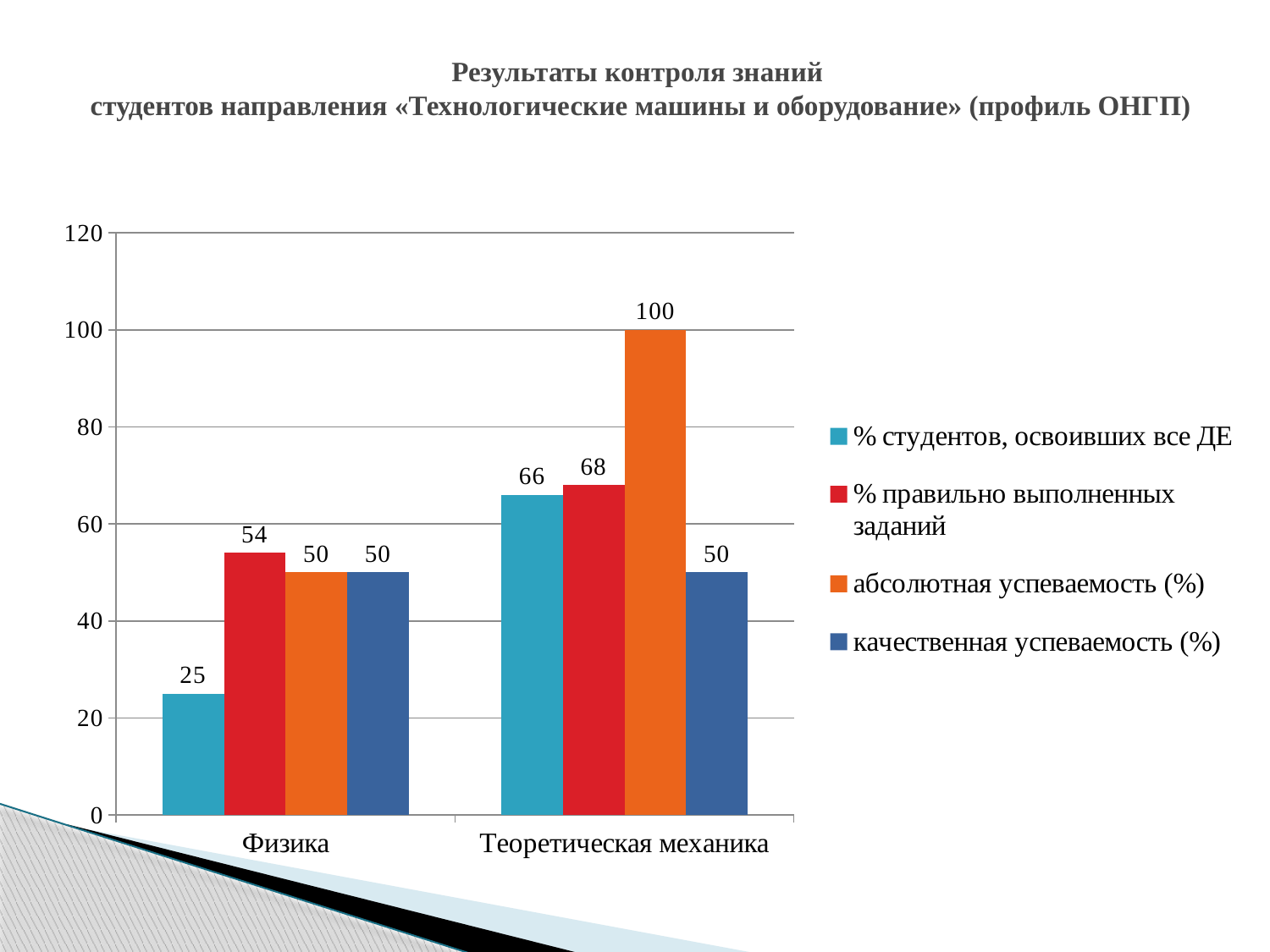
What is the value of «% студентов, освоивших все ДЕ» for Физика? 25 How many series does the legend list? 4 What is the value of «% правильно выполненных заданий» for Физика? 54 Which series has the lowest value for Физика? % студентов, освоивших все ДЕ What kind of chart is shown on the slide? bar chart How many categories are shown on the x axis? 2 What is the value of «абсолютная успеваемость (%)» for Теоретическая механика? 100 What is the difference between «% студентов, освоивших все ДЕ» for Теоретическая механика and for Физика? 41 Which is larger: «% правильно выполненных заданий» for Физика or for Теоретическая механика? Теоретическая механика Is the value of «абсолютная успеваемость (%)» for Физика greater or less than 60? less What is the value of «качественная успеваемость (%)» for Теоретическая механика? 50 Which series has the highest value for Теоретическая механика? абсолютная успеваемость (%)